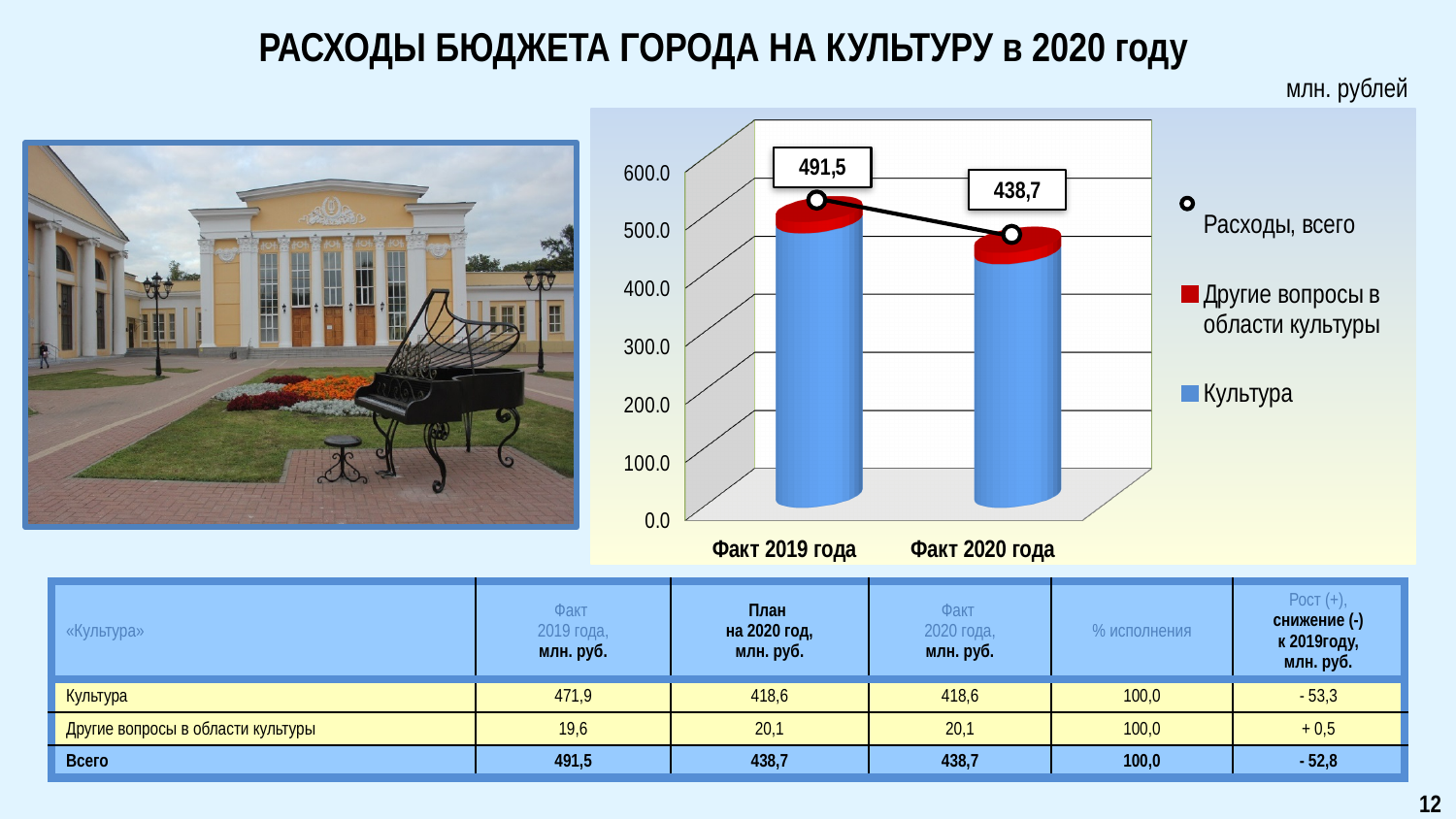
Which category has the higher total expenditure ('Расходы, всего')? Факт 2019 года How many series does the chart legend list? 3 Is the 'Культура' segment for 'Факт 2020 года' greater or less than 500.0? less Is the 'Культура' segment for 'Факт 2019 года' greater or less than 400.0? greater What is the value of the 'Расходы, всего' line for 'Факт 2020 года'? 438,7 What is the value of the 'Расходы, всего' line for 'Факт 2019 года'? 491,5 Does the 'Расходы, всего' line rise or fall from 'Факт 2019 года' to 'Факт 2020 года'? fall Which category has the lower total expenditure ('Расходы, всего')? Факт 2020 года What kind of chart is shown on the slide? Stacked bar chart with a line By how much does the 'Расходы, всего' value for 'Факт 2019 года' exceed that for 'Факт 2020 года'? 52,8 How many categories are shown on the x axis of the chart? 2 Is the 'Расходы, всего' value larger for 'Факт 2019 года' or 'Факт 2020 года'? Факт 2019 года